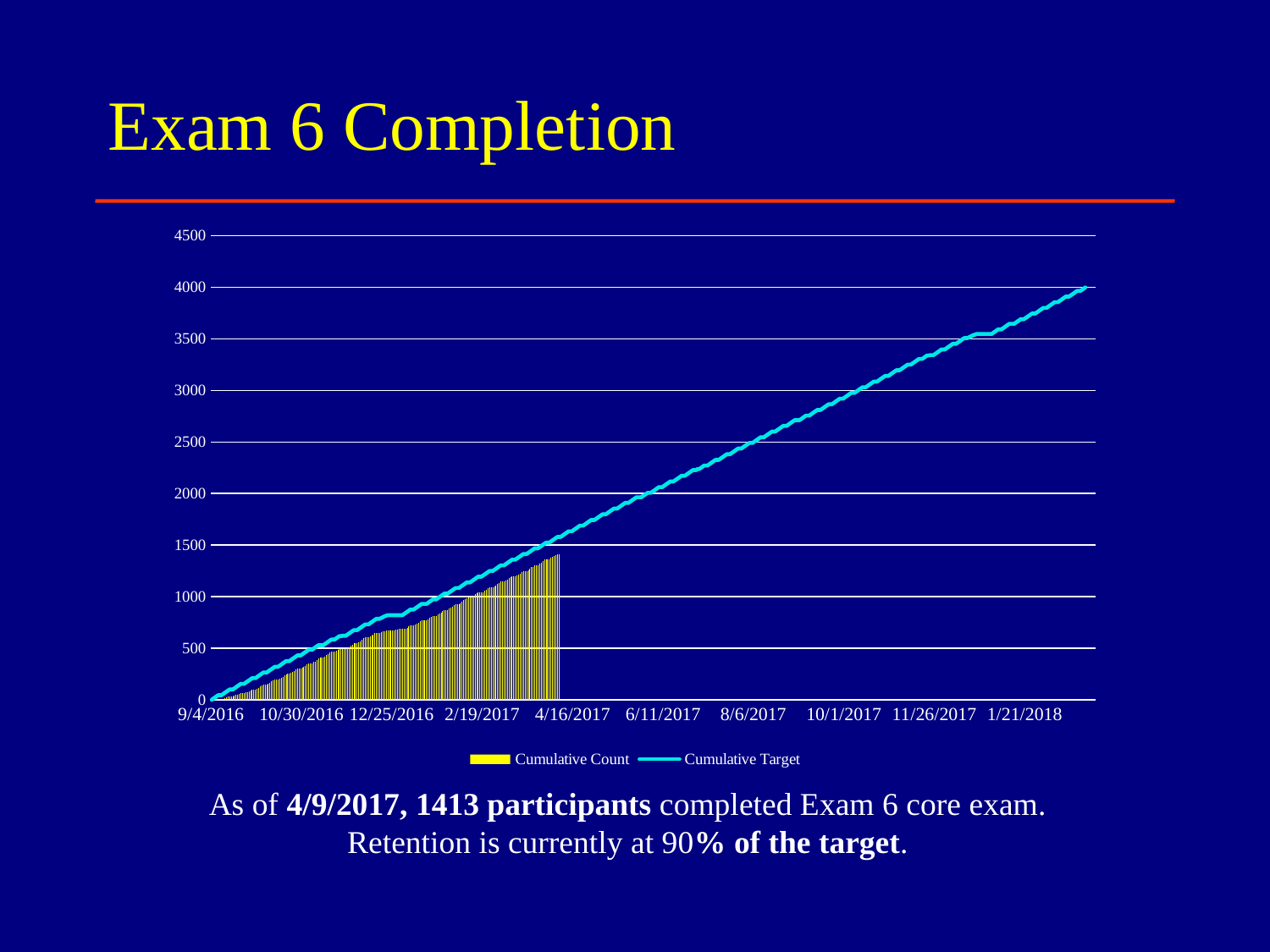
Is the Cumulative Count value at 12/25/2016 greater or less than 1000? less Is the Cumulative Target value at 10/1/2017 greater or less than 2500? greater Is the Cumulative Target value at 12/25/2016 greater or less than 1000? less What kind of chart is shown on the slide? A combined bar and line chart How many series does the legend list? 2 How many date labels are shown on the x axis? 10 Does the Cumulative Target line rise or fall from 9/4/2016 to 1/21/2018? Rises What are the two series named in the legend? Cumulative Count and Cumulative Target What is the highest value shown on the y axis? 4500